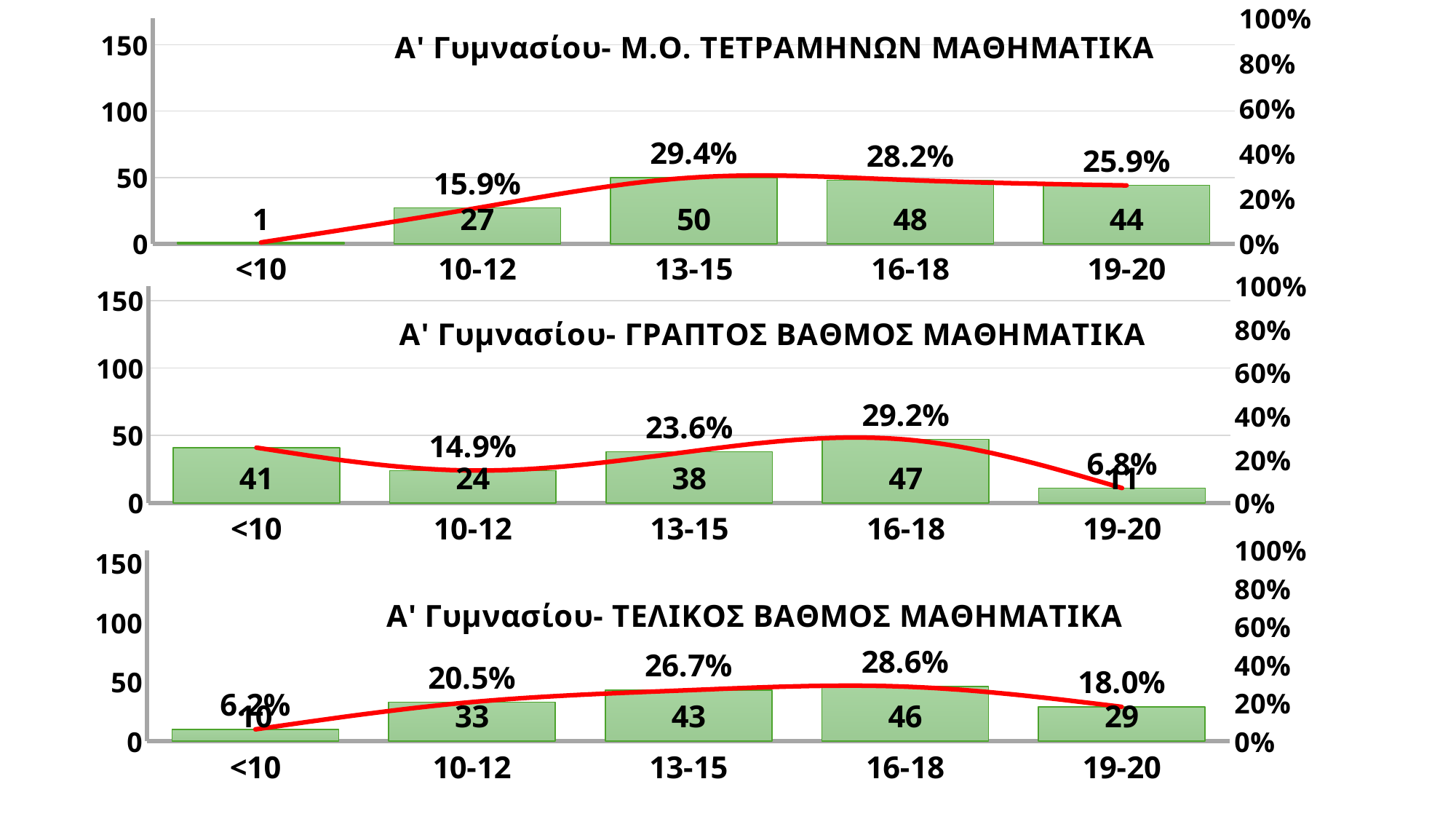
In the bottom chart (Α' Γυμνασίου- ΤΕΛΙΚΟΣ ΒΑΘΜΟΣ ΜΑΘΗΜΑΤΙΚΑ), which is larger, the bar value for 13-15 or for 19-20? 13-15 In the top chart (Α' Γυμνασίου- Μ.Ο. ΤΕΤΡΑΜΗΝΩΝ ΜΑΘΗΜΑΤΙΚΑ), which category has the lowest bar value? <10 In the middle chart (Α' Γυμνασίου- ΓΡΑΠΤΟΣ ΒΑΘΜΟΣ ΜΑΘΗΜΑΤΙΚΑ), what is the bar value for the <10 category? 41 In the bottom chart (Α' Γυμνασίου- ΤΕΛΙΚΟΣ ΒΑΘΜΟΣ ΜΑΘΗΜΑΤΙΚΑ), what percentage is shown for the <10 category? 6.2% In the top chart (Α' Γυμνασίου- Μ.Ο. ΤΕΤΡΑΜΗΝΩΝ ΜΑΘΗΜΑΤΙΚΑ), what is the bar value for the 13-15 category? 50 In the top chart (Α' Γυμνασίου- Μ.Ο. ΤΕΤΡΑΜΗΝΩΝ ΜΑΘΗΜΑΤΙΚΑ), is the bar value for 16-18 greater or less than 100? less In the middle chart (Α' Γυμνασίου- ΓΡΑΠΤΟΣ ΒΑΘΜΟΣ ΜΑΘΗΜΑΤΙΚΑ), which category has the highest bar value? 16-18 In the bottom chart (Α' Γυμνασίου- ΤΕΛΙΚΟΣ ΒΑΘΜΟΣ ΜΑΘΗΜΑΤΙΚΑ), what is the bar value for the 10-12 category? 33 How many categories are shown on the x axis of the bottom chart (Α' Γυμνασίου- ΤΕΛΙΚΟΣ ΒΑΘΜΟΣ ΜΑΘΗΜΑΤΙΚΑ)? 5 In the middle chart (Α' Γυμνασίου- ΓΡΑΠΤΟΣ ΒΑΘΜΟΣ ΜΑΘΗΜΑΤΙΚΑ), what percentage is shown for the 13-15 category? 23.6% In the top chart (Α' Γυμνασίου- Μ.Ο. ΤΕΤΡΑΜΗΝΩΝ ΜΑΘΗΜΑΤΙΚΑ), what percentage is shown for the 19-20 category? 25.9% In the middle chart (Α' Γυμνασίου- ΓΡΑΠΤΟΣ ΒΑΘΜΟΣ ΜΑΘΗΜΑΤΙΚΑ), what is the difference between the bar values for 16-18 and 19-20? 36